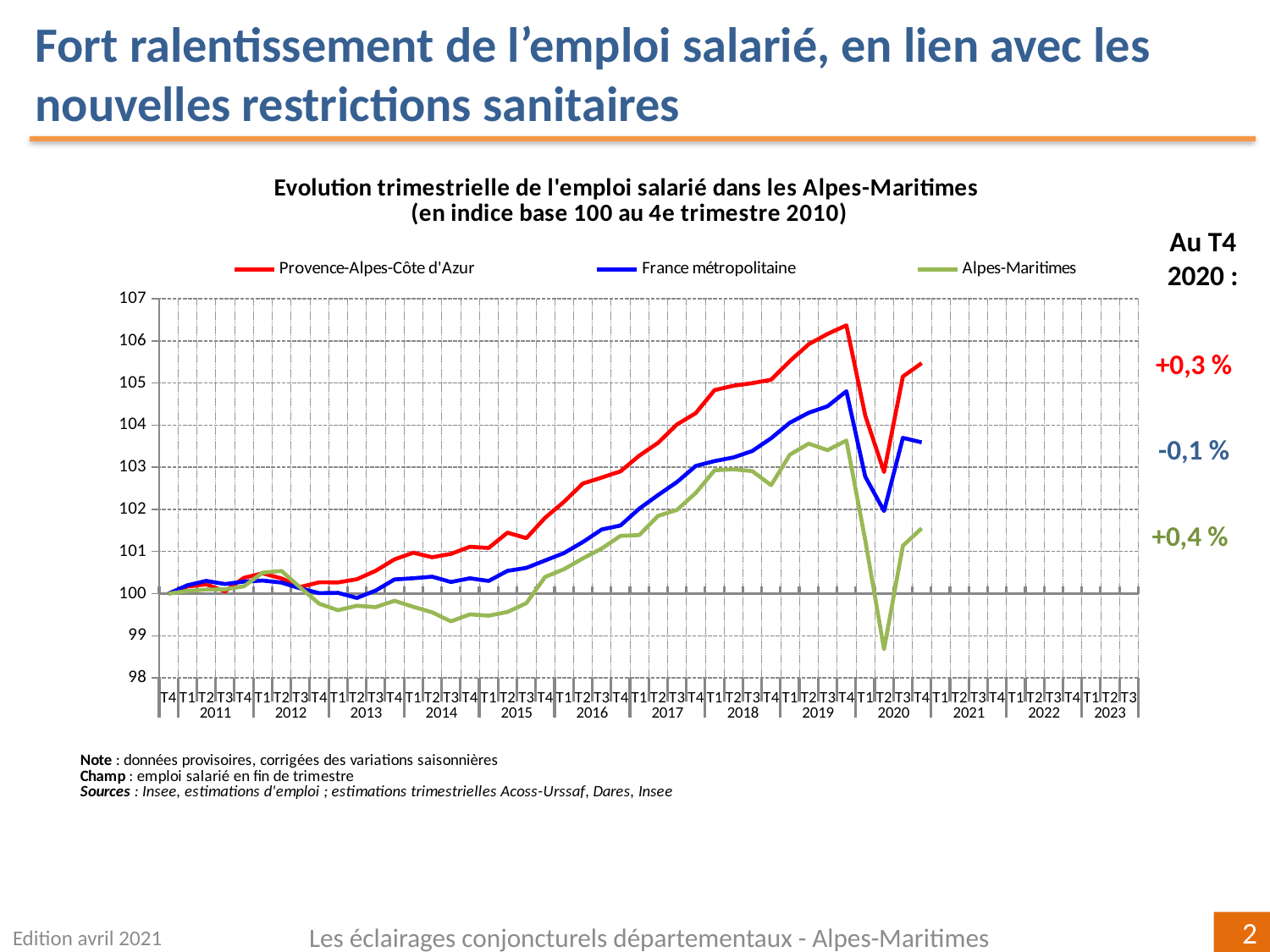
Does the Alpes-Maritimes series rise or fall between T1 2020 and T2 2020? fall What change is printed for Alpes-Maritimes at T4 2020? +0,4 % How many series does the legend of the chart list? 3 What kind of chart is shown on the slide? line chart What change is printed for Provence-Alpes-Côte d'Azur at T4 2020? +0,3 % Is the value for Provence-Alpes-Côte d'Azur at T4 2019 greater or less than 106? greater Which series has the lowest value at T2 2020? Alpes-Maritimes Is the value for Alpes-Maritimes at T2 2020 greater or less than 99? less Which series is drawn in green in the chart? Alpes-Maritimes At T4 2019, which series is higher: Provence-Alpes-Côte d'Azur or Alpes-Maritimes? Provence-Alpes-Côte d'Azur According to the chart title, what is the base of the index (value 100)? 4e trimestre 2010 What change is printed for France métropolitaine at T4 2020? -0,1 %